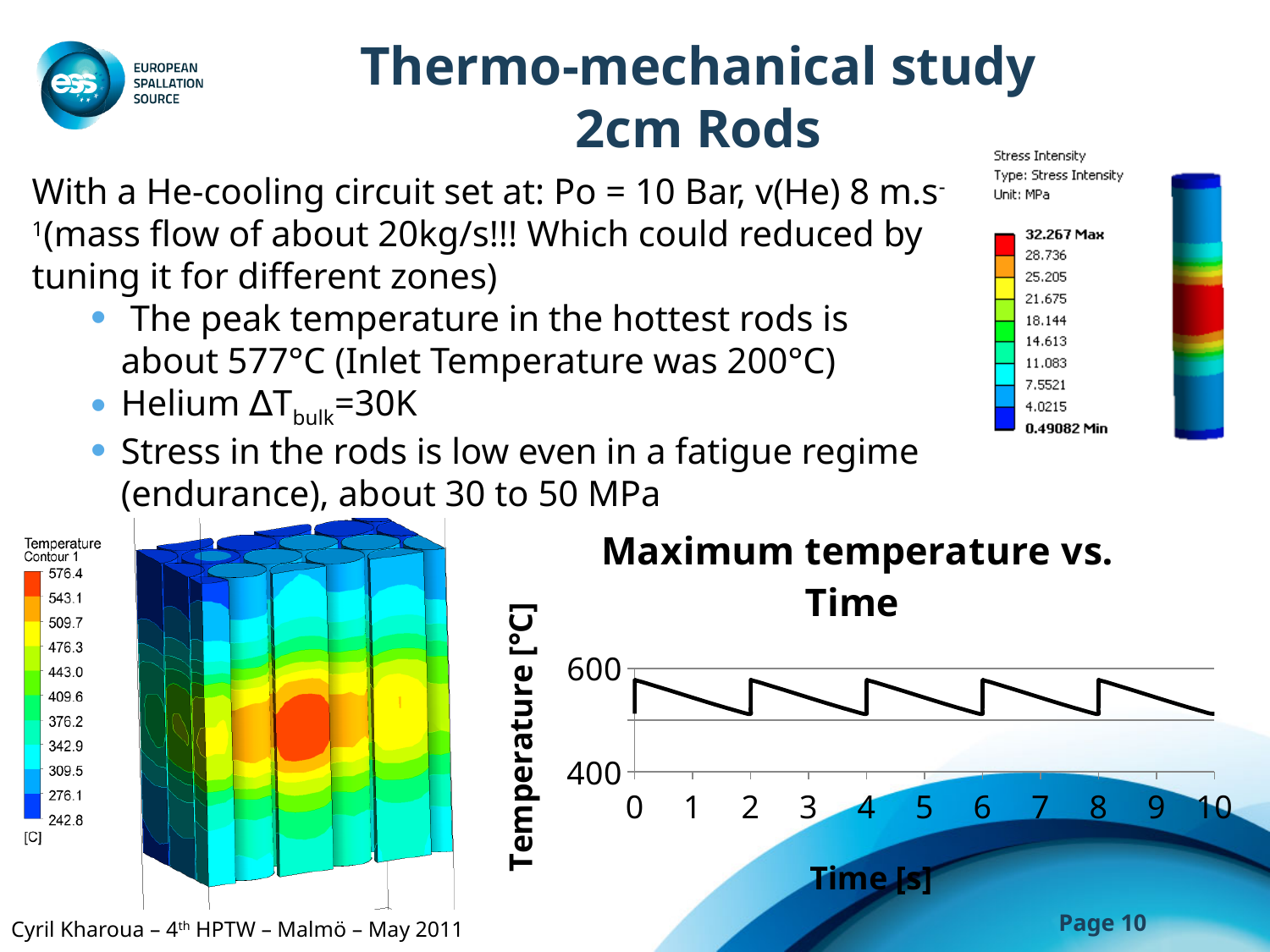
In the "Maximum temperature vs. Time" chart, how does the temperature behave between two consecutive peaks, for example from 2 s to 4 s? it falls gradually In the "Maximum temperature vs. Time" chart, is the temperature at time 1 s greater or less than 400? greater In the "Maximum temperature vs. Time" chart, is the temperature at 2 s (just before the jump) higher or lower than at 0 s (just after the jump)? lower In the "Maximum temperature vs. Time" chart, is the temperature at any point greater or less than 400? greater In the "Maximum temperature vs. Time" chart, how many sharp peaks does the temperature line show between 0 and 10 s? 5 What is the label of the x axis of the "Maximum temperature vs. Time" chart? Time [s] In the "Maximum temperature vs. Time" chart, what is the overall pattern of the temperature line over time? a repeating sawtooth: sharp rise then gradual fall What is the title of the chart at the bottom right of the slide? Maximum temperature vs. Time What kind of chart is the "Maximum temperature vs. Time" chart? line chart In the "Maximum temperature vs. Time" chart, how many labelled tick marks are on the x axis? 11 In the "Maximum temperature vs. Time" chart, what is the largest value shown on the x axis? 10 In the "Maximum temperature vs. Time" chart, is the highest temperature reached greater or less than 600? less